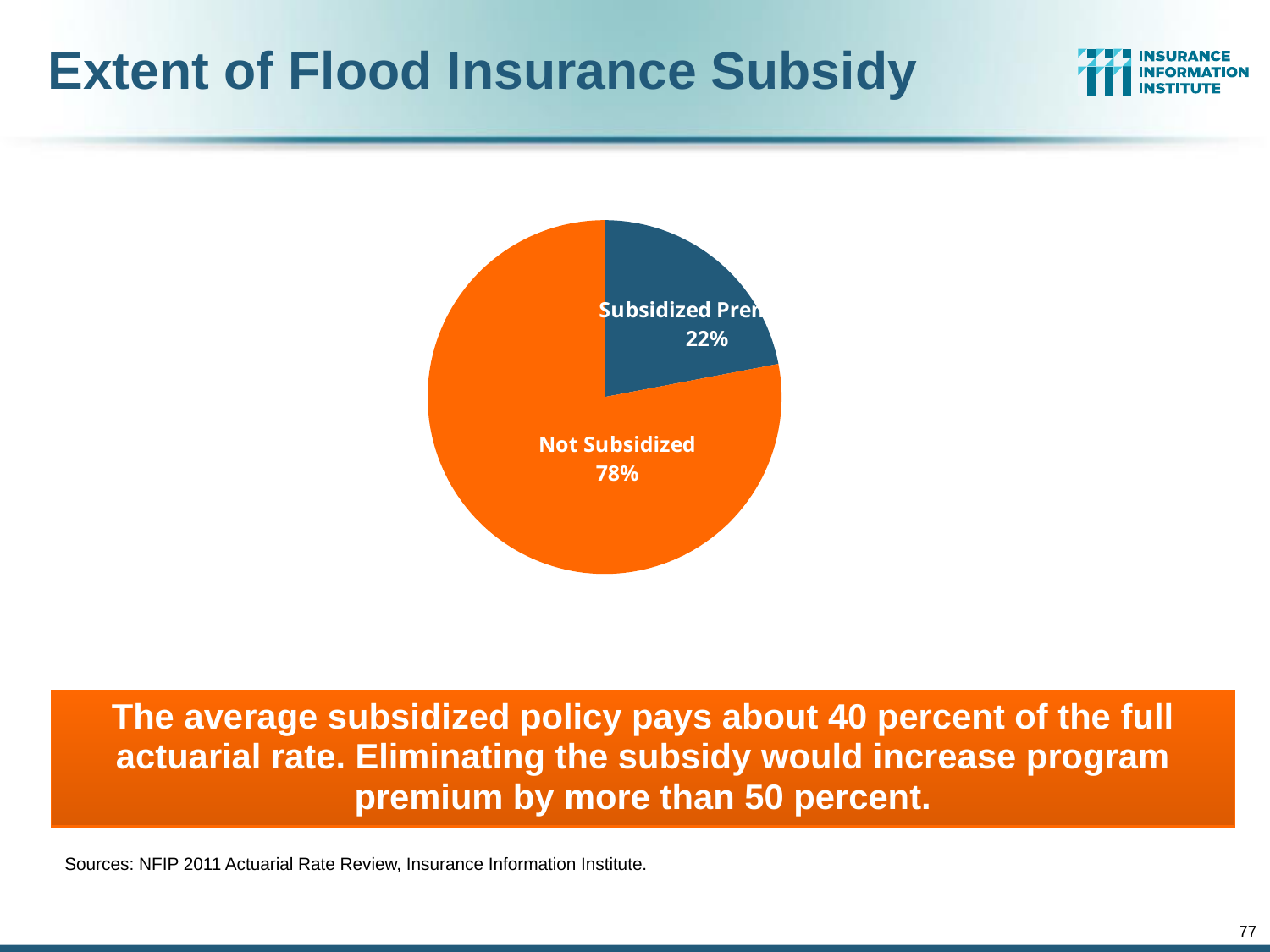
Which slice of the pie is the smallest? Subsidized Is the Not Subsidized share of the pie greater or less than 50%? greater What share of the pie is labelled Not Subsidized? 78% What colour is the Not Subsidized slice of the pie? Orange What colour is the Subsidized slice of the pie? Dark blue Is the Subsidized share of the pie greater or less than 25%? less What is the difference in percentage points between the Not Subsidized slice and the Subsidized slice? 56 What kind of chart is shown on the slide? Pie chart Which is larger, the Not Subsidized slice or the Subsidized slice? Not Subsidized What share of the pie does the Subsidized slice represent? 22% How many slices does the pie chart have? 2 Which slice of the pie is the largest? Not Subsidized